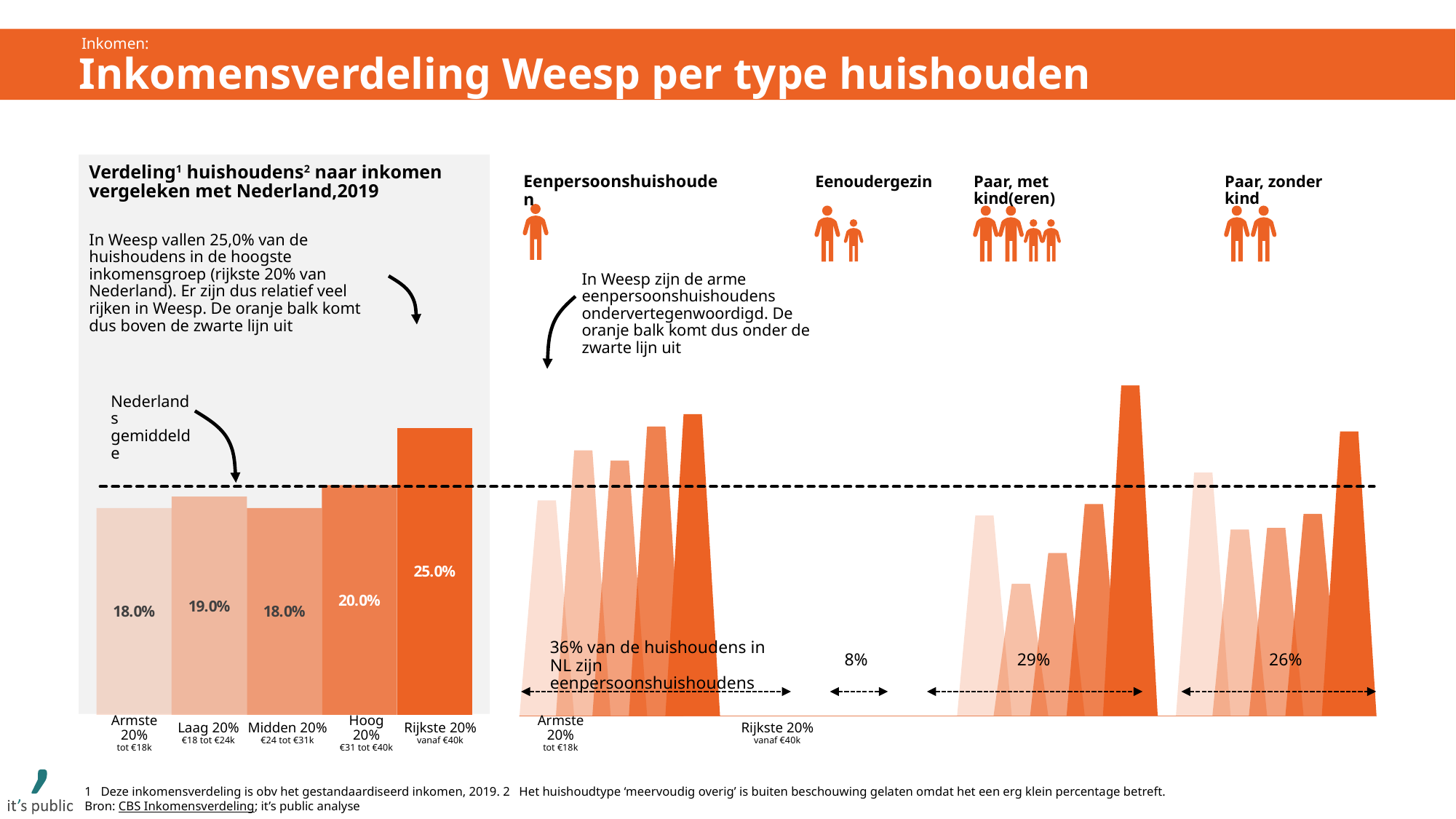
In the left chart, what is the value for Laag 20%? 19.0% In the left chart, how many income groups are shown on the x axis? 5 In the left chart, what is the difference between the values for Rijkste 20% and Armste 20%? 7.0% In the left chart 'Verdeling huishoudens naar inkomen vergeleken met Nederland, 2019', what is the value for Rijkste 20%? 25.0% In the left chart, what does the dashed horizontal line represent? Nederlands gemiddelde What kind of chart is the left chart 'Verdeling huishoudens naar inkomen vergeleken met Nederland, 2019'? bar chart In the left chart, what is the value for Hoog 20%? 20.0% In the left chart, which is larger: the value for Laag 20% or the value for Midden 20%? Laag 20% In the right-hand charts, which is larger: the share for Paar, met kind(eren) or the share for Paar, zonder kind? Paar, met kind(eren) In the right-hand charts, what percentage is shown for Eenoudergezin? 8% In the right-hand charts, what percentage of households in NL are eenpersoonshuishoudens? 36% In the left chart, which income group has the highest share of households in Weesp? Rijkste 20%